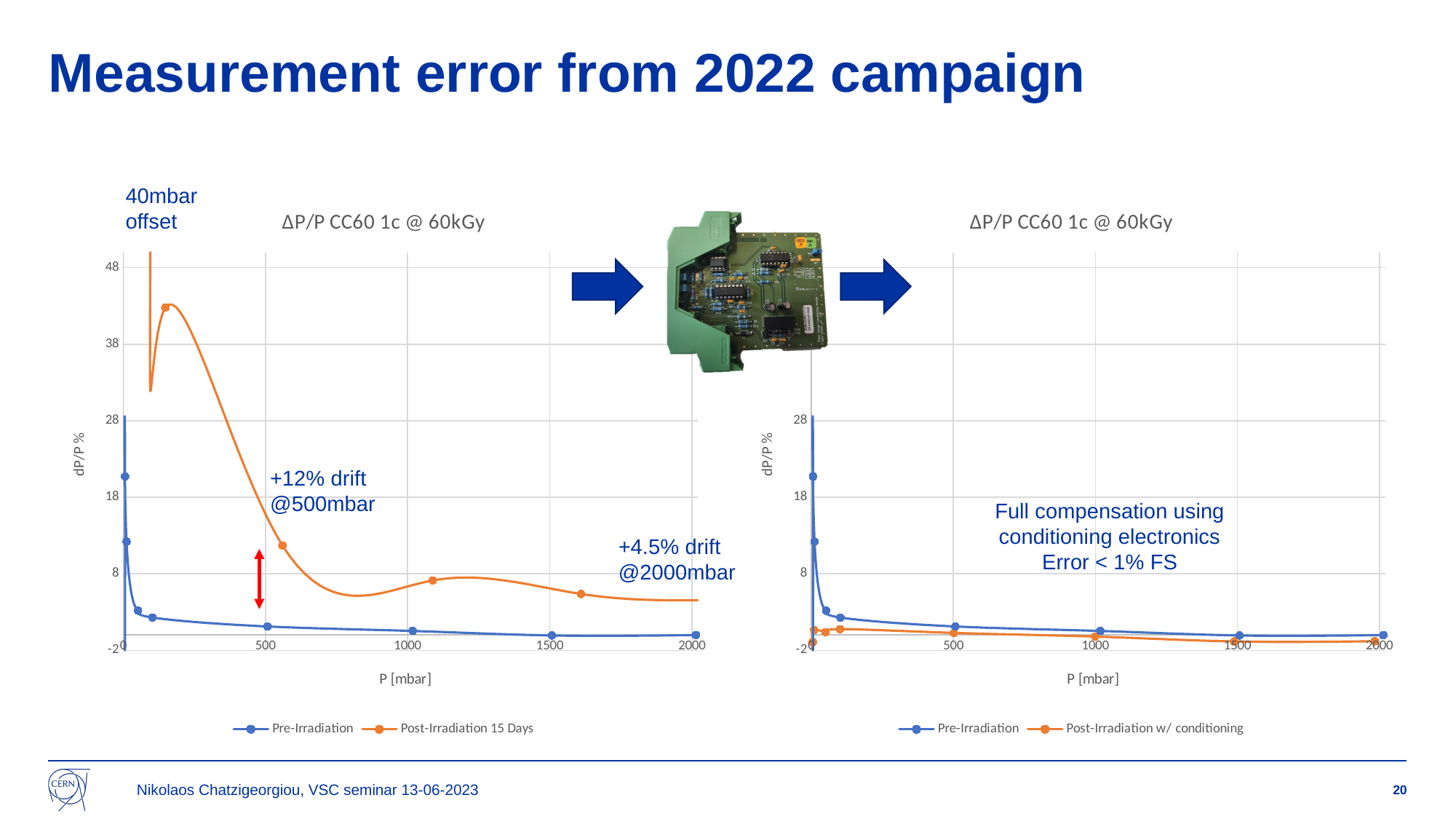
In the right chart, is the value of Post-Irradiation w/ conditioning at 2000 mbar greater or less than 8? less In the left chart, which series has the larger value at 1000 mbar, Pre-Irradiation or Post-Irradiation 15 Days? Post-Irradiation 15 Days In the left chart, is the value of Post-Irradiation 15 Days at 500 mbar greater or less than 8? greater What is the x-axis label of the right chart? P [mbar] In the left chart, does the Pre-Irradiation series rise or fall as P increases from 0 to 2000 mbar? fall What kind of chart is the left chart on the slide? line chart How many series does the legend of the right chart list? 2 In the left chart, is the value of Pre-Irradiation at 500 mbar greater or less than 8? less How many series does the legend of the left chart list? 2 In the left chart, which series reaches the highest dP/P % value? Post-Irradiation 15 Days What is the name of the orange series in the legend of the right chart? Post-Irradiation w/ conditioning